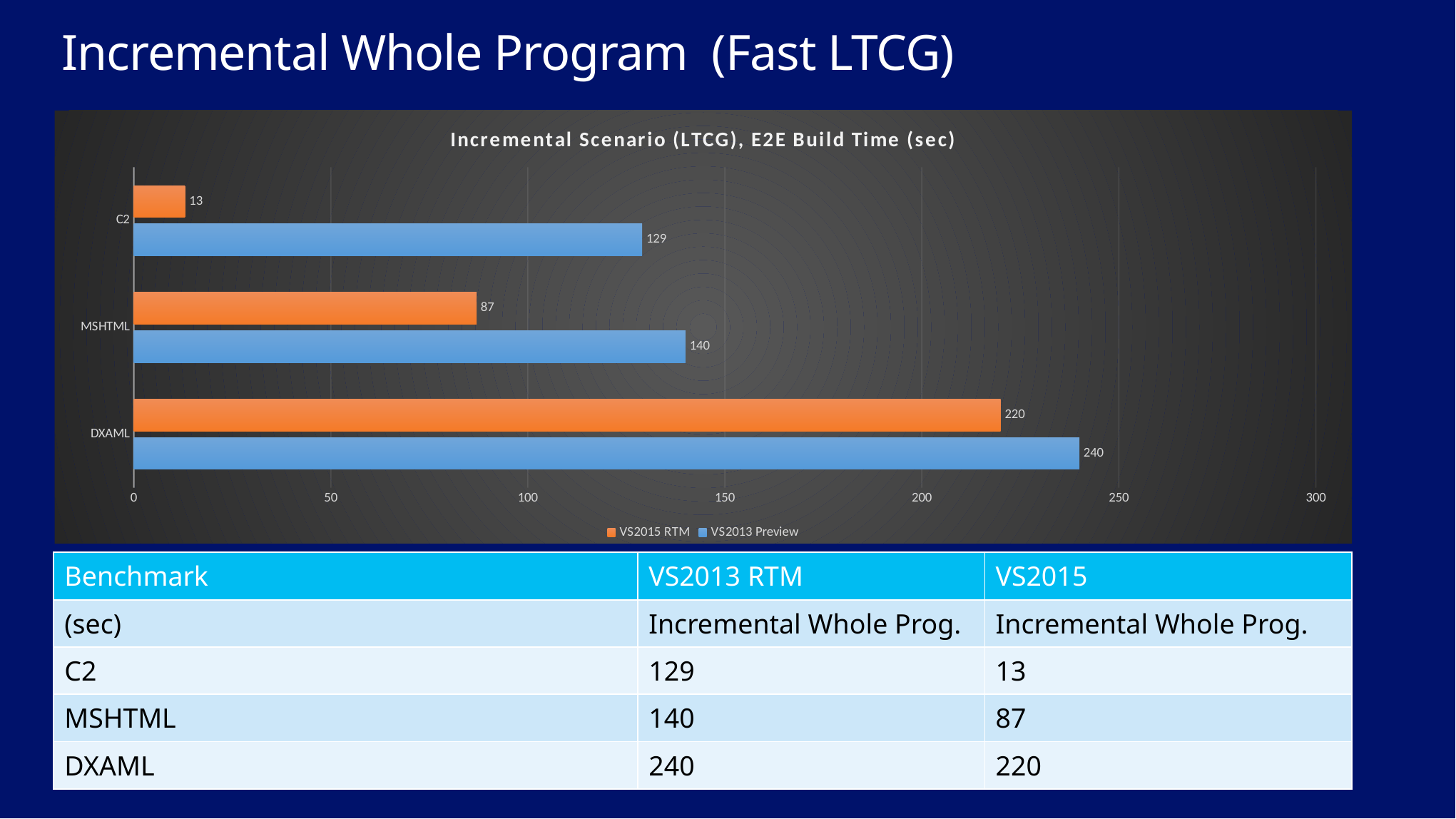
How many benchmarks are shown on the chart? 3 What is the VS2015 RTM value for C2? 13 What is the VS2015 RTM value for DXAML? 220 What is the title of the chart? Incremental Scenario (LTCG), E2E Build Time (sec) What kind of chart is shown? Bar chart What is the VS2013 Preview value for MSHTML? 140 Which benchmark has the highest VS2013 Preview value? DXAML Which benchmark has the lowest VS2015 RTM value? C2 What is the difference between the VS2013 Preview and VS2015 RTM values for MSHTML? 53 How many series does the legend list? 2 Which is larger for DXAML: the VS2015 RTM value or the VS2013 Preview value? VS2013 Preview What is the difference between the VS2013 Preview and VS2015 RTM values for C2? 116